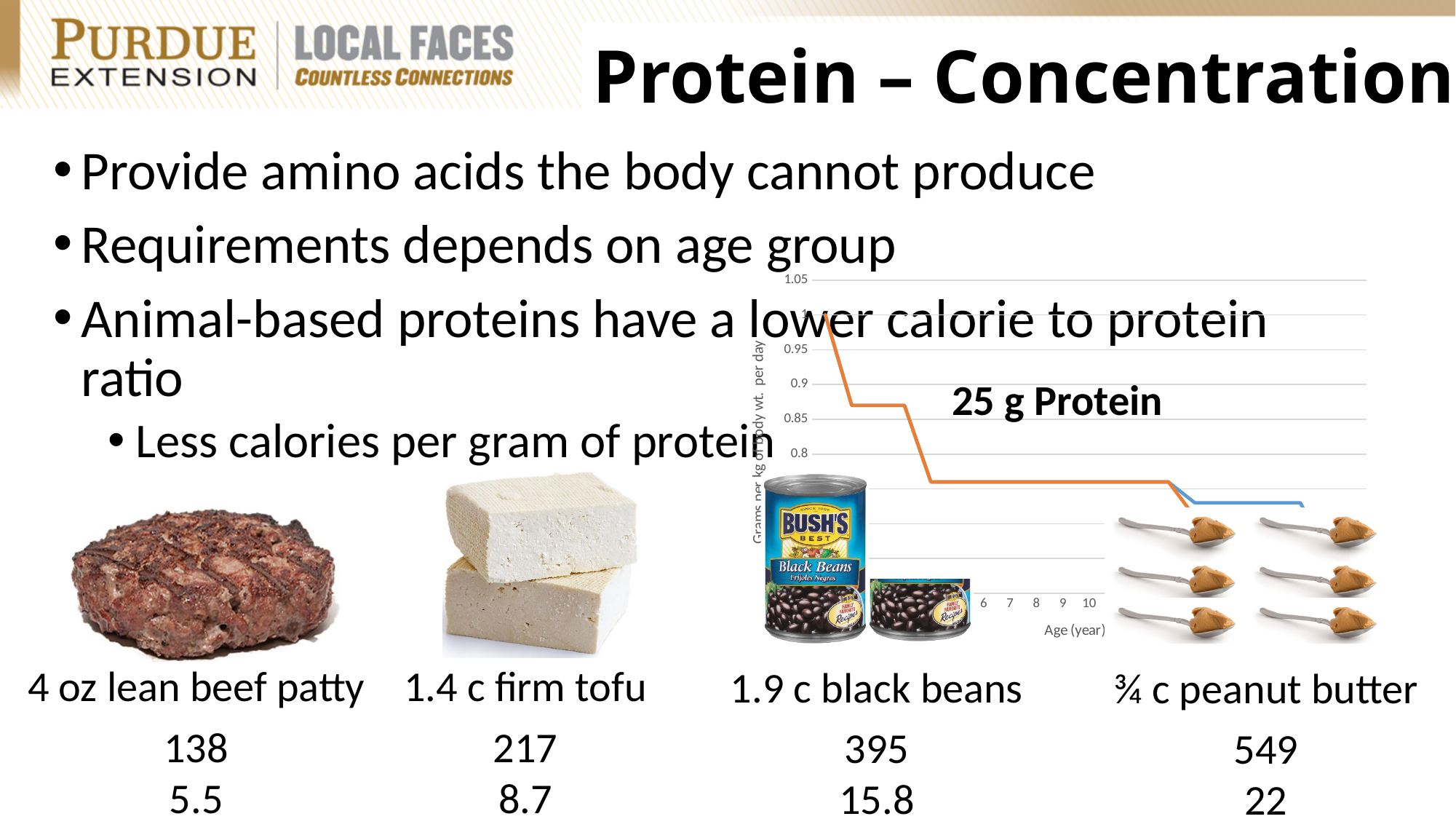
In the line chart, is the highest value of the orange line greater or less than 0.95? greater What is the highest tick value shown on the y axis of the line chart? 1.05 What colours are the two lines in the line chart? orange and blue In the line chart, is the value of the orange line at age 8 greater or less than 0.8? less In the line chart, does the orange line rise or fall as age increases along the x axis? fall How many lines are plotted in the line chart? 2 What kind of chart is shown on the right side of the slide? line chart What is the label of the x axis of the line chart? Age (year)